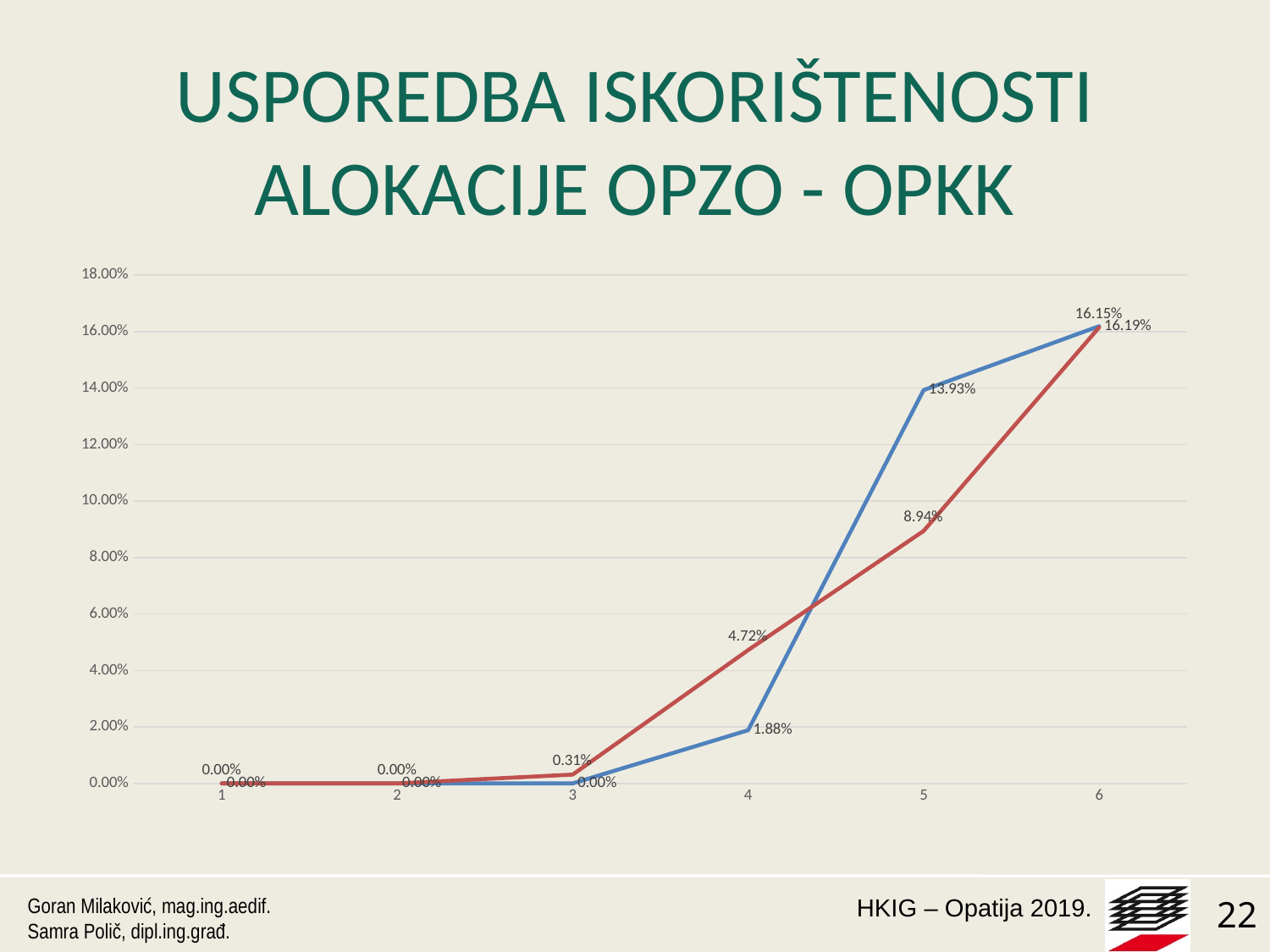
What kind of chart is shown on the slide? line chart What is the value of the red line at x-axis point 4? 4.72% How many lines are plotted on the chart? 2 What is the value of the blue line at x-axis point 5? 13.93% Does the blue line rise or fall from x-axis point 1 to point 6? rises What is the value of the blue line at x-axis point 4? 1.88% What is the difference between the blue line and the red line at x-axis point 5? 4.99% What is the title of the chart slide? USPOREDBA ISKORIŠTENOSTI ALOKACIJE OPZO - OPKK What is the value of the red line at x-axis point 5? 8.94% What is the value of the red line at x-axis point 3? 0.31% At x-axis point 4, which line has the higher value, the blue or the red? red How many points are there along the x axis of the chart? 6